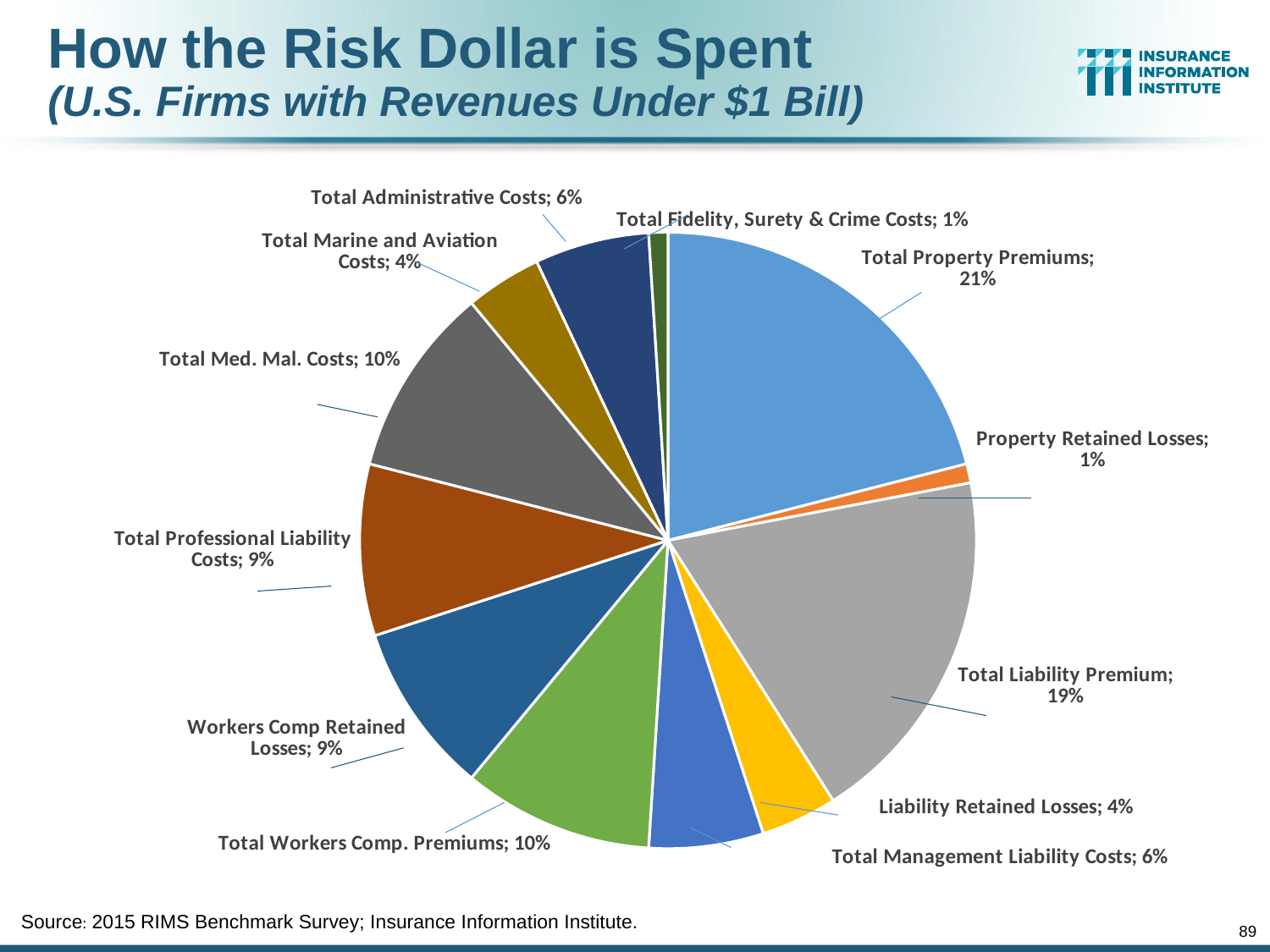
What is the title of the chart on the slide? How the Risk Dollar is Spent (U.S. Firms with Revenues Under $1 Bill) What type of chart is shown on the slide? Pie chart What share is labelled for Total Marine and Aviation Costs? 4% What percentage is shown for Total Fidelity, Surety & Crime Costs? 1% What percentage is shown for Total Liability Premium? 19% How many percentage points larger is Total Property Premiums than Total Liability Premium? 2 percentage points What is the combined share of Total Property Premiums and Property Retained Losses? 22% What percentage is shown for Total Med. Mal. Costs? 10% What share of the risk dollar goes to Total Property Premiums? 21% Which category has the largest slice of the pie? Total Property Premiums How many slices does the pie chart have? 12 Which is larger, Total Workers Comp. Premiums or Workers Comp Retained Losses? Total Workers Comp. Premiums